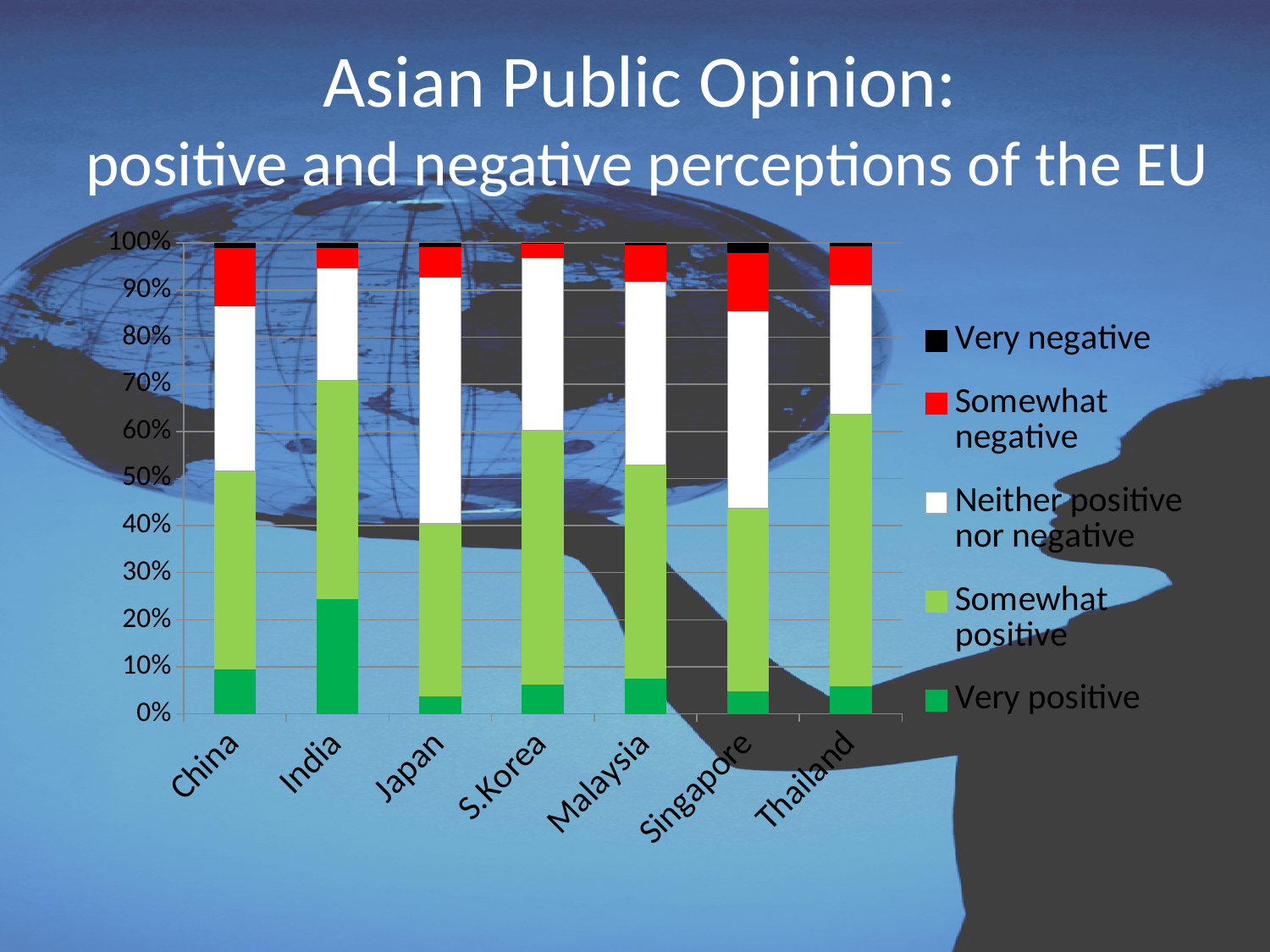
Which country has the highest Very positive value? India What does each stacked bar in the chart total? 100% Which country has the larger Very positive value, China or Japan? China How many series does the chart's legend list? 5 How many countries are shown on the x axis of the chart? 7 Is the Very positive value for India greater or less than 20%? greater Which country has the lowest Very positive value? Japan Which country has the larger Very positive value, India or Singapore? India Is the Very positive value for Malaysia greater or less than 10%? less What colour represents the Somewhat negative series in the legend? Red What kind of chart is shown on the slide? Stacked bar chart